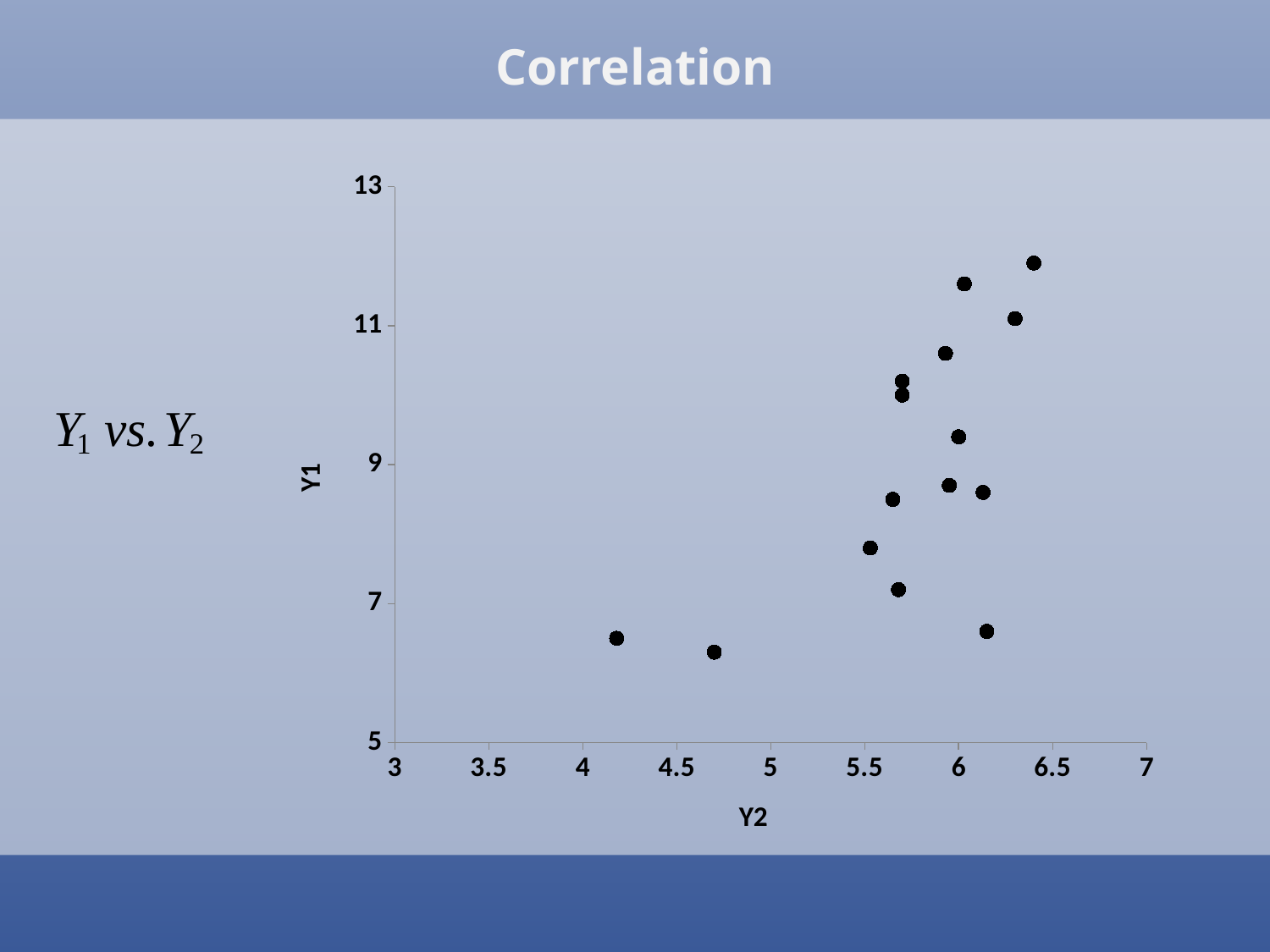
How many data points are plotted on the chart? 15 How many data points have a Y2 value less than 5? 2 Is the Y2 value of the leftmost point on the chart greater or less than 4.5? less What is the maximum value shown on the vertical (Y1) axis? 13 Are there more data points with Y2 above 5.5 or below 5.5? above 5.5 Is the Y1 value of the lowest point on the chart greater or less than 7? less Is the Y1 value of the highest point on the chart greater or less than 11? greater What kind of chart is shown on the slide? scatter plot What is the label of the vertical axis of the chart? Y1 What is the label of the horizontal axis of the chart? Y2 Do the Y1 values generally rise or fall as Y2 increases along the x axis? rise